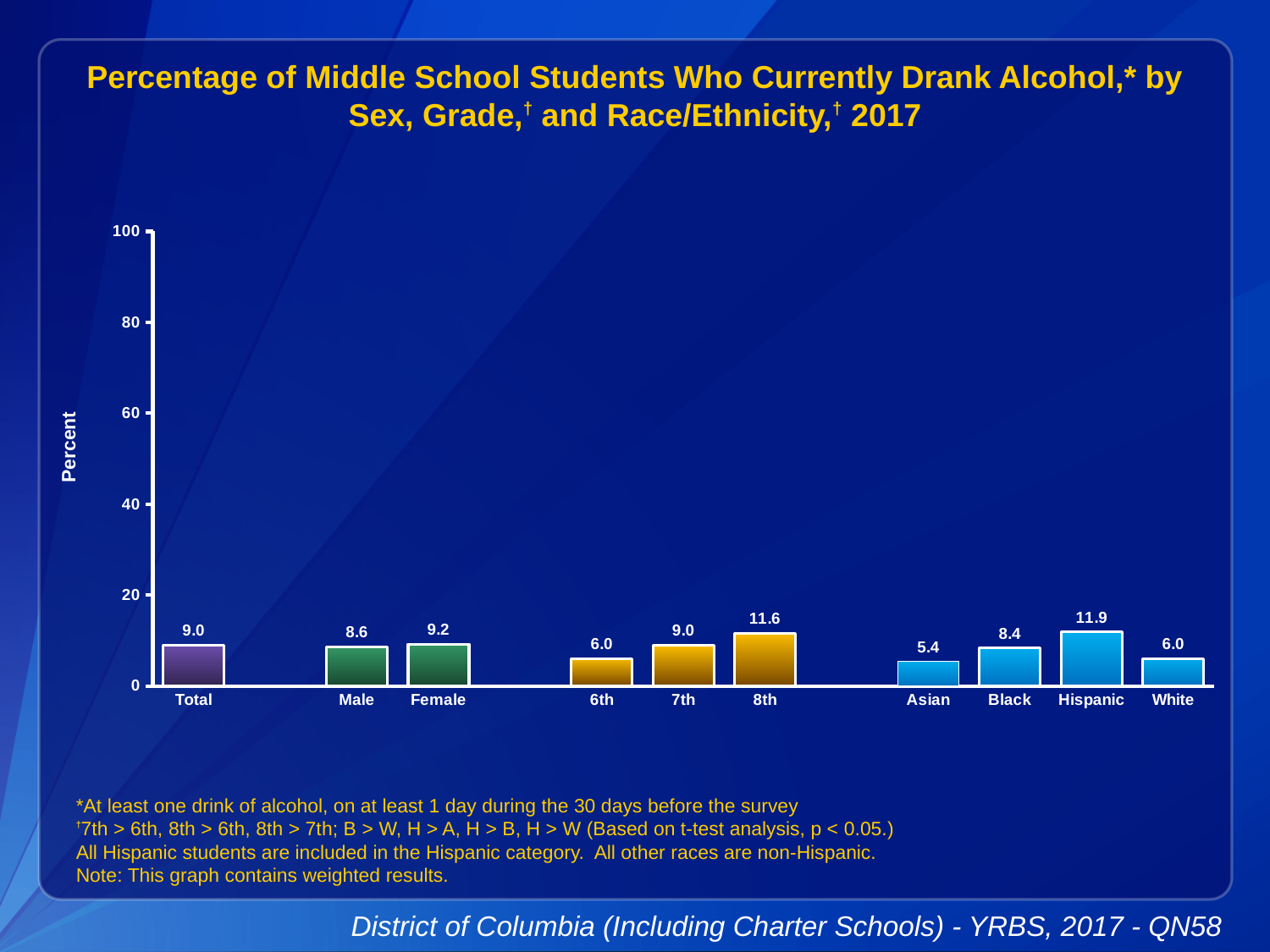
What is the value for Asian? 5.4 What is the value for Female? 9.2 Which is larger, the value for Black or the value for White? Black What kind of chart is this? bar chart Is the value for Hispanic greater or less than 20? less What is the value for 8th grade? 11.6 What is the difference between the values for 8th and 6th grade? 5.6 How many categories are shown on the x axis? 10 What is the value for Total? 9.0 What is the difference between the values for Female and Male? 0.6 Which category has the lowest value? Asian Which category has the highest value? Hispanic